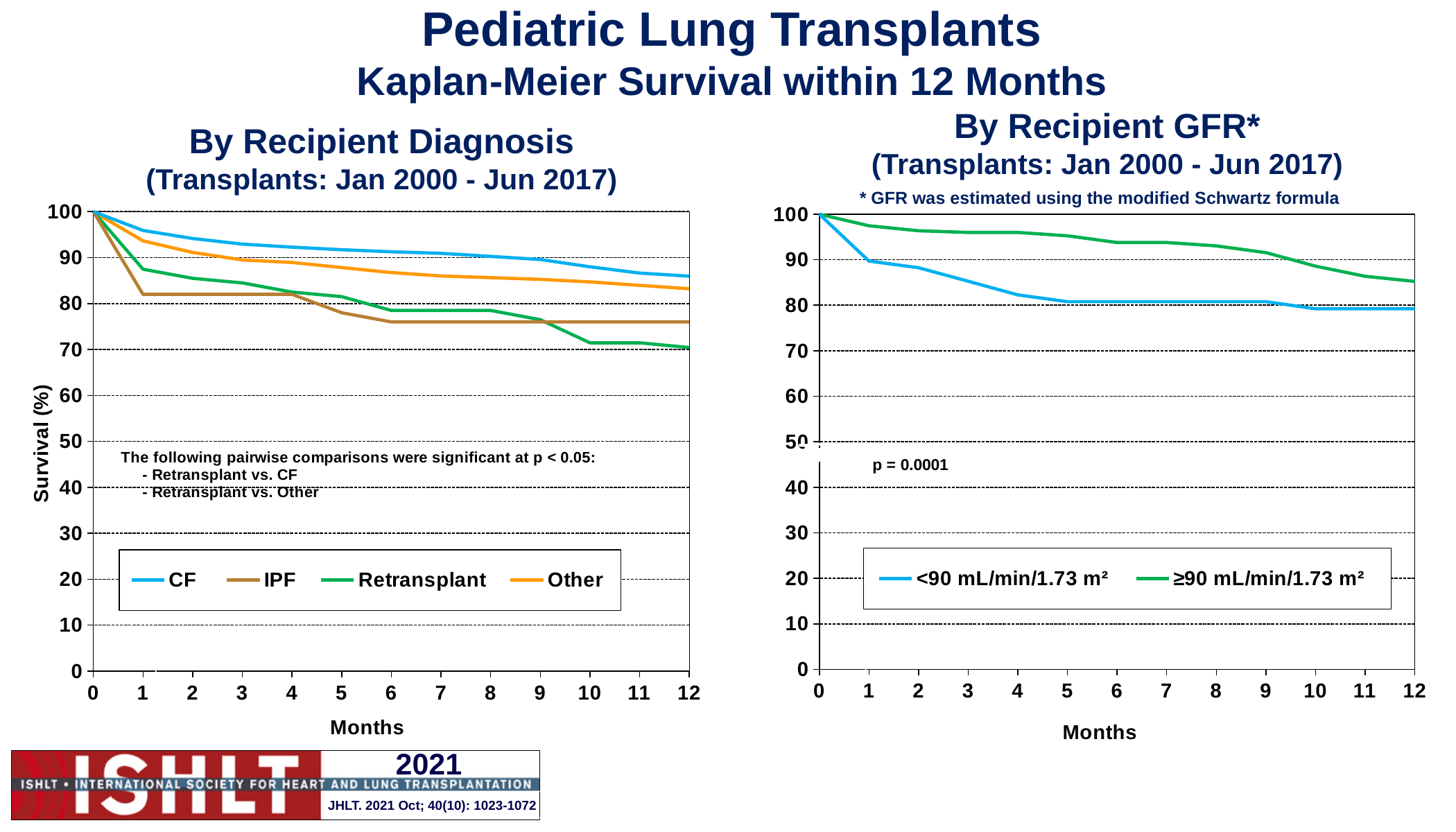
In the 'By Recipient GFR*' chart, which series has the higher survival at 12 months? ≥90 mL/min/1.73 m² In the 'By Recipient GFR*' chart, is the survival for <90 mL/min/1.73 m² at 3 months greater or less than 90? less In the 'By Recipient Diagnosis' chart, which series has the highest survival at 12 months? CF In the 'By Recipient Diagnosis' chart, is the survival for Retransplant at 12 months greater or less than 80? less How many series does the legend of the 'By Recipient Diagnosis' chart list? 4 How many series does the legend of the 'By Recipient GFR*' chart list? 2 In the 'By Recipient Diagnosis' chart, does the CF survival curve rise or fall as months increase? fall What kind of chart is the 'By Recipient Diagnosis' chart on the left? line chart In the 'By Recipient Diagnosis' chart, which is larger at 12 months: survival for IPF or survival for Other? Other What p-value is shown on the 'By Recipient GFR*' chart? p = 0.0001 In the 'By Recipient Diagnosis' chart, which series has the lowest survival at 12 months? Retransplant In the 'By Recipient Diagnosis' chart, is the survival for CF at 12 months greater or less than 80? greater